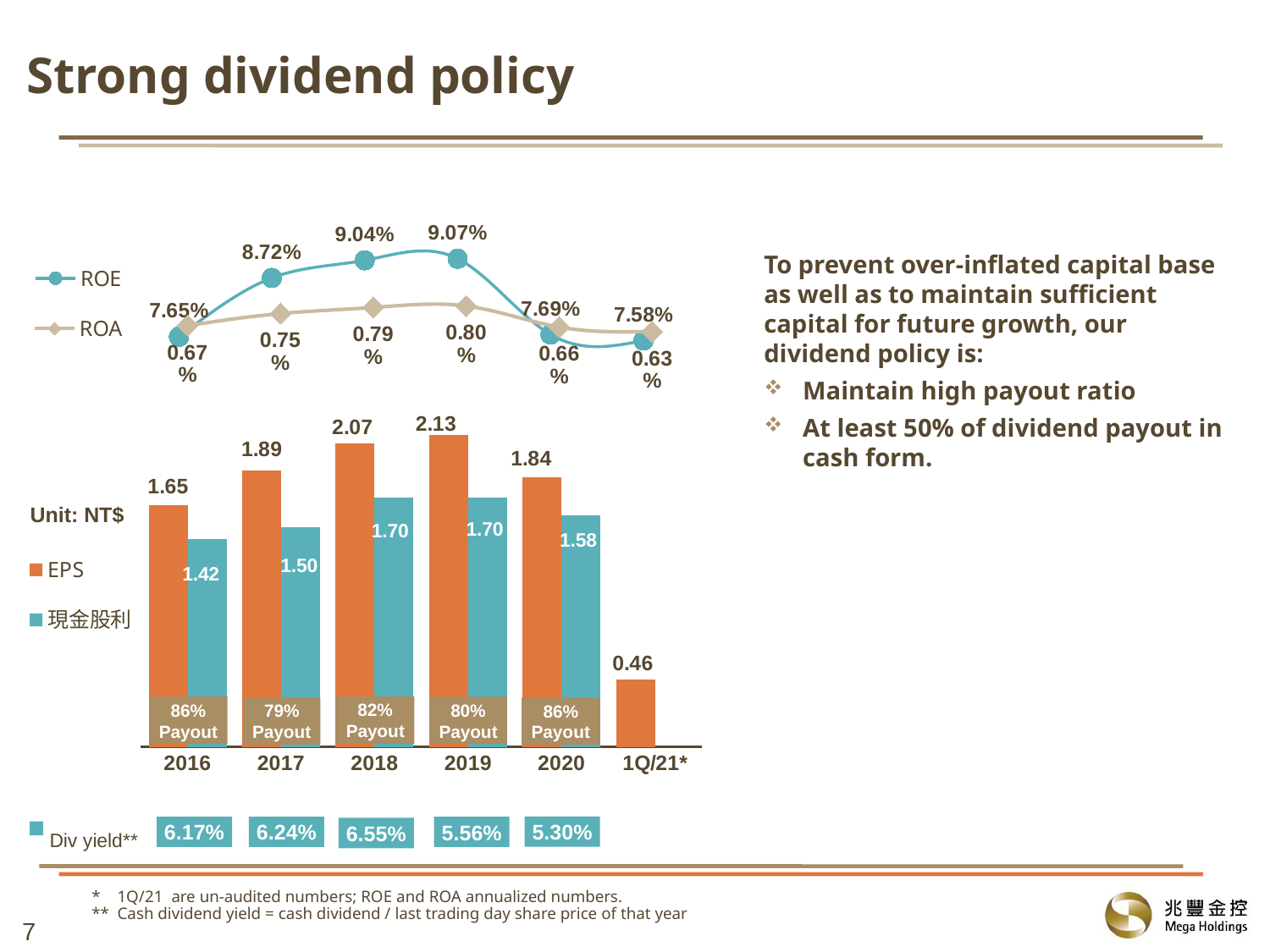
In the top line chart, how many series does the legend list? 2 In the top line chart, what is the ROA value for 2017? 0.75% In the bottom bar chart, what is the EPS for 2018? 2.07 In the top line chart, which year has the lowest ROA? 1Q/21 In the top line chart, what is the ROE value for 2019? 9.07% What kind of chart is the bottom chart showing EPS and cash dividend? Bar chart In the bottom bar chart, which year has the highest EPS? 2019 In the bottom bar chart, what is the cash dividend (現金股利) for 2020? 1.58 In the top line chart, what is the difference between the ROE for 2018 and the ROE for 2016? 1.39% In the bottom bar chart, is the EPS for 2017 larger or the EPS for 2020? 2017 In the bottom bar chart, what is the difference between the EPS and the cash dividend for 2016? 0.23 In the bottom bar chart, what is the payout ratio shown for 2018? 82%